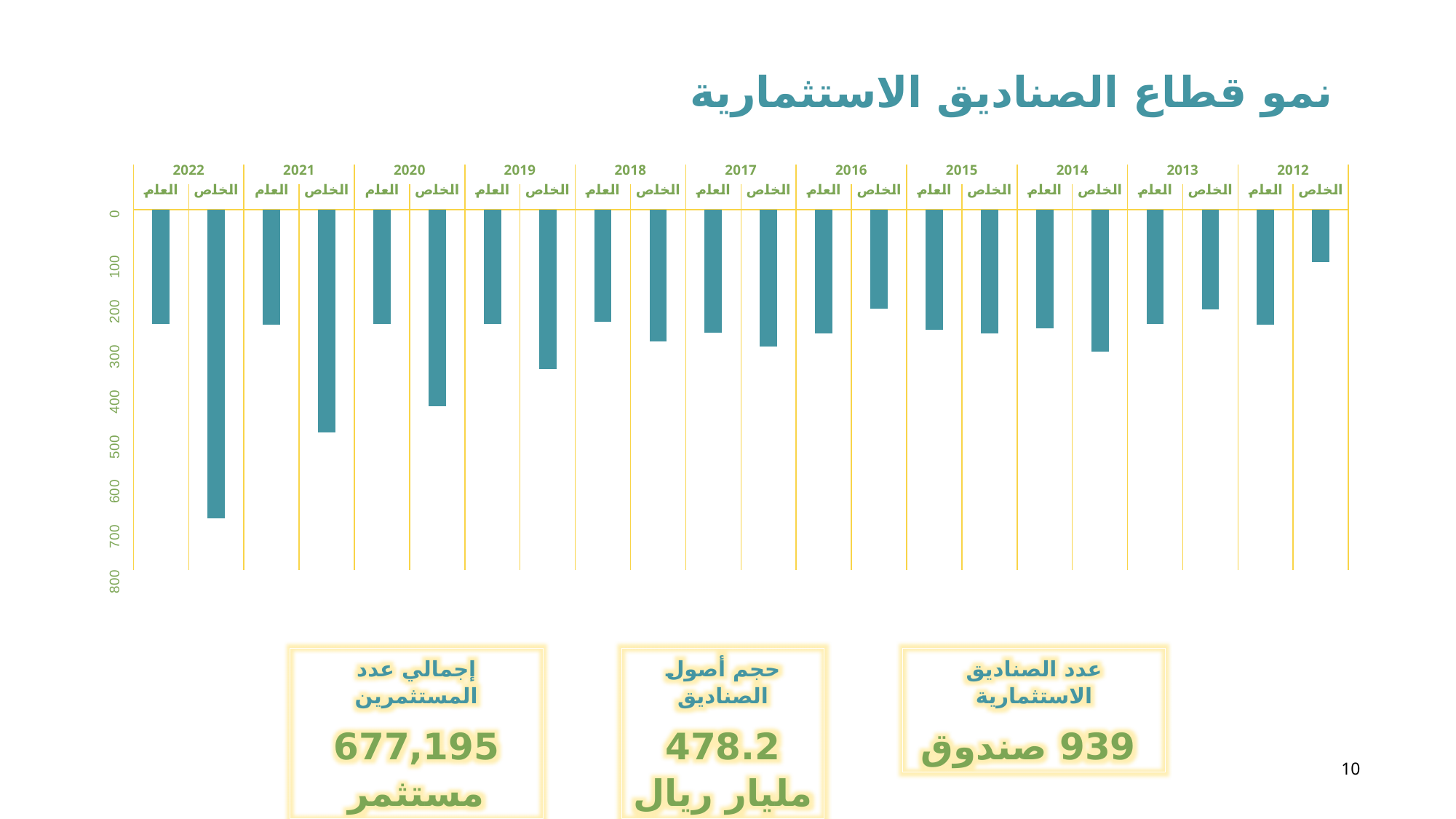
Is the value for العام in 2022 greater or less than 300? less Which bar is the shortest in the chart? الخاص 2012 Which is larger in 2016, العام or الخاص? العام Which is larger, الخاص in 2022 or الخاص in 2021? الخاص in 2022 What is the title of the chart? نمو قطاع الصناديق الاستثمارية Overall, do the الخاص values rise or fall from 2012 to 2022? rise Is the value for الخاص in 2022 greater or less than 600? greater How many years are shown in the chart? 11 What kind of chart is shown on the slide? bar chart Is the value for الخاص in 2012 greater or less than 200? less Which bar is the longest in the chart? الخاص 2022